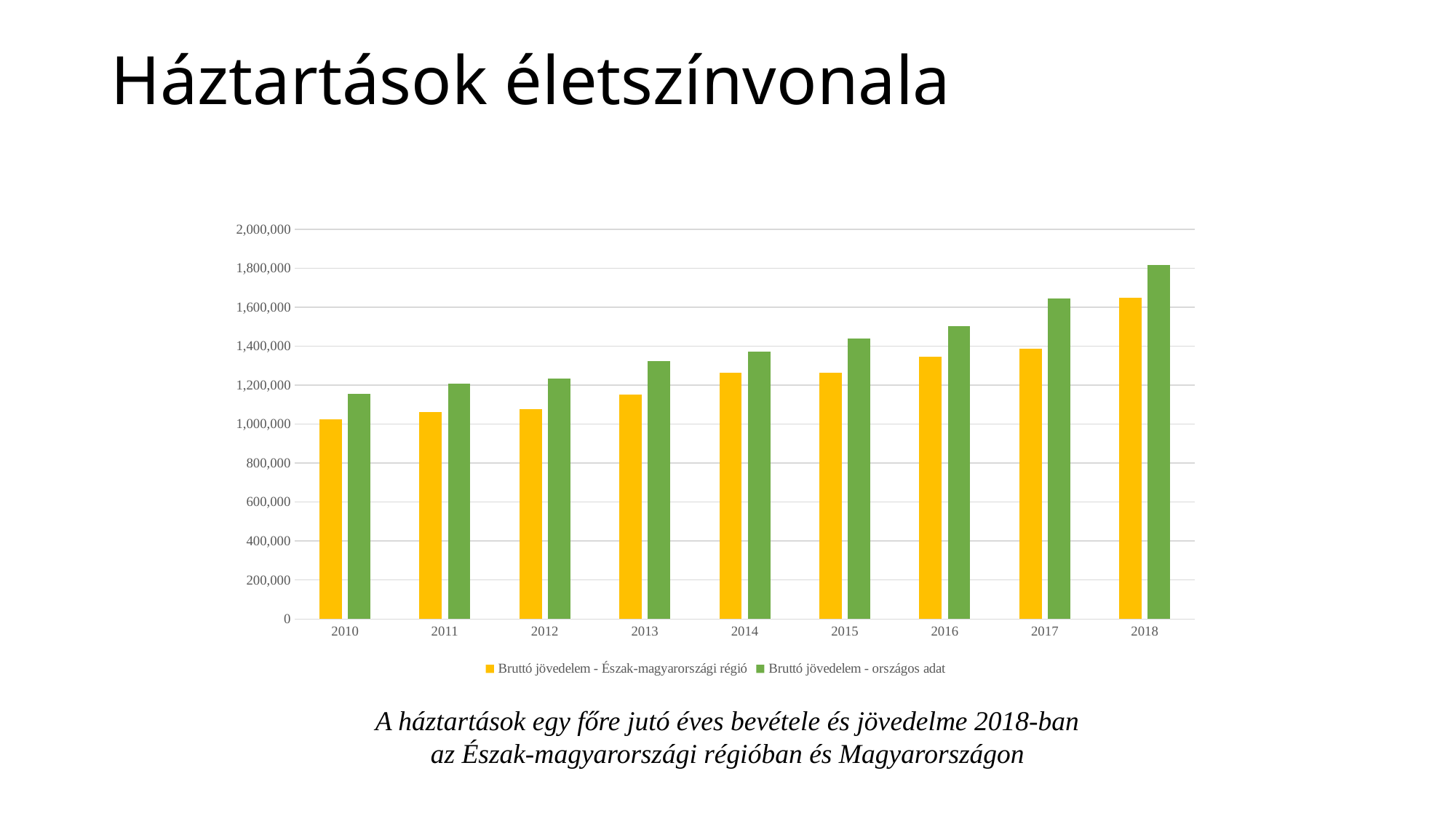
How many years are shown on the x axis? 9 What kind of chart is shown on the slide? Bar chart In which year is the value for 'Bruttó jövedelem - Észak-magyarországi régió' the lowest? 2010 Is the value for 'Bruttó jövedelem - országos adat' in 2018 greater or less than 1,600,000? greater How many series does the legend list? 2 Is the value for 'Bruttó jövedelem - Észak-magyarországi régió' in 2013 greater or less than 1,200,000? less Which colour represents 'Bruttó jövedelem - Észak-magyarországi régió' in the chart? Yellow In which year is the value for 'Bruttó jövedelem - országos adat' the highest? 2018 In 2017, which series has the larger value: 'Bruttó jövedelem - Észak-magyarországi régió' or 'Bruttó jövedelem - országos adat'? Bruttó jövedelem - országos adat Do the values for 'Bruttó jövedelem - országos adat' generally rise or fall from 2010 to 2018? Rise Is the value for 'Bruttó jövedelem - Észak-magyarországi régió' in 2010 greater or less than 1,200,000? less